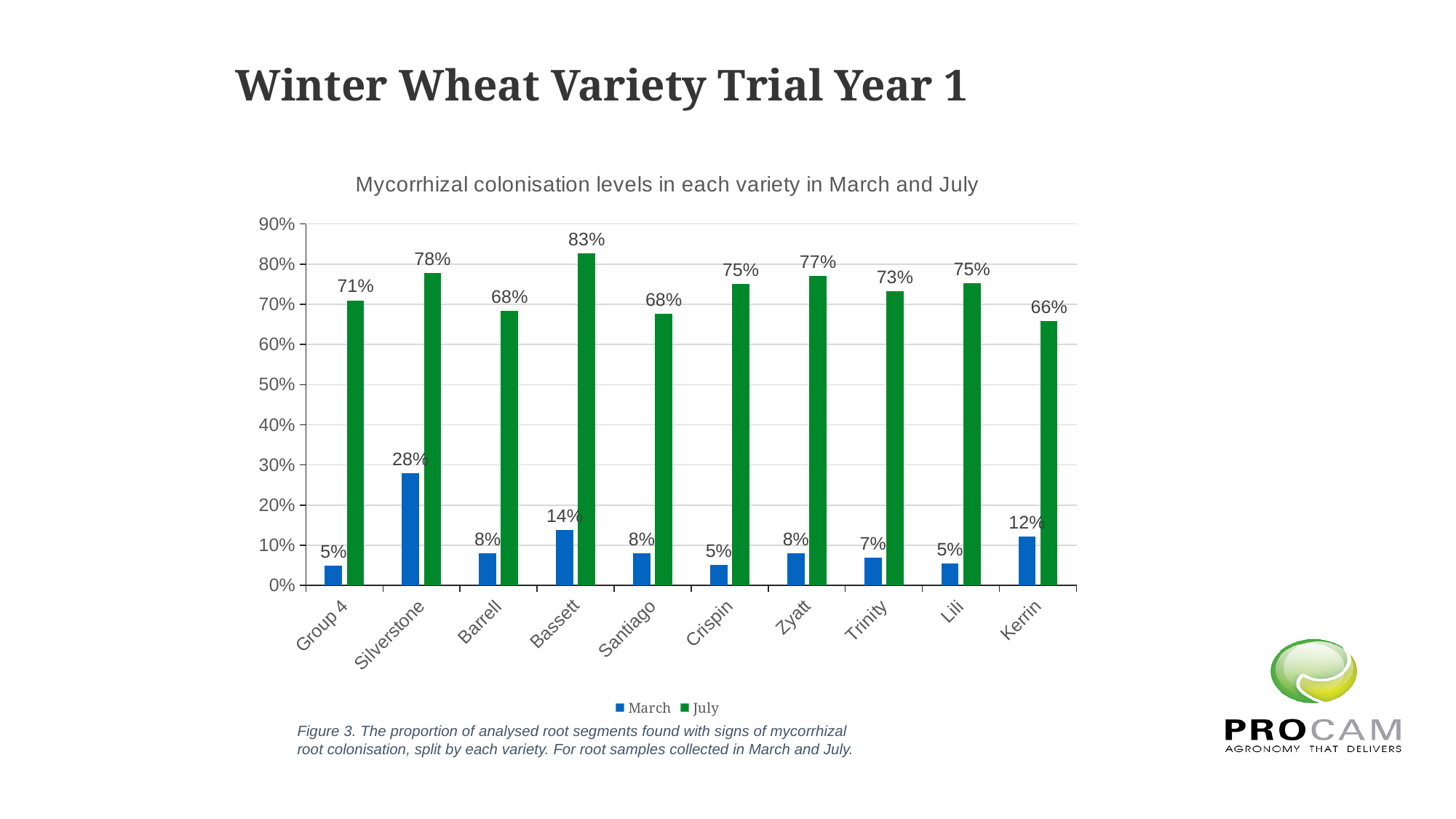
What type of chart is shown? Bar chart What is the July value for Kerrin? 66% Which variety has the highest July colonisation level? Bassett How many varieties are shown on the x axis? 10 Which variety has the lowest July colonisation level? Kerrin What is the March mycorrhizal colonisation level for Silverstone? 28% How many series does the legend list? 2 What is the July mycorrhizal colonisation level for Bassett? 83% Which is larger, the July value for Silverstone or the July value for Zyatt? Silverstone Which variety has the highest March colonisation level? Silverstone What is the title of the chart? Mycorrhizal colonisation levels in each variety in March and July What is the difference between the July and March values for Bassett? 69%